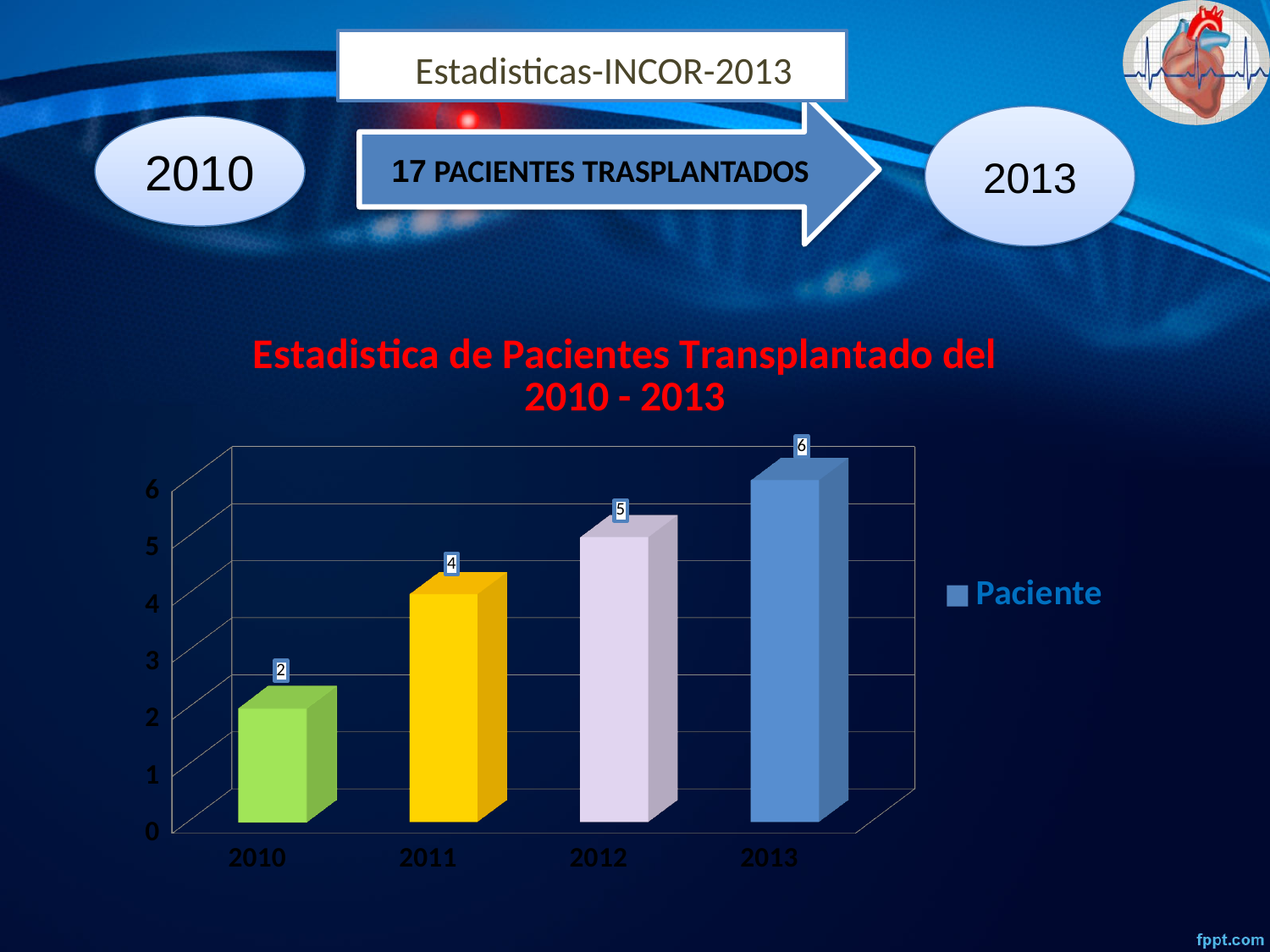
What kind of chart is shown? bar chart Which year has the highest value? 2013 What is the value for 2012? 5 What is the value for 2010? 2 What is the difference between the values for 2013 and 2010? 4 What is the value for 2013? 6 Which year has the lowest value? 2010 Which is larger, the value for 2011 or the value for 2012? 2012 What is the value for 2011? 4 How many series does the legend list? 1 Do the values rise or fall from 2010 to 2013? rise How many years are shown on the x axis? 4